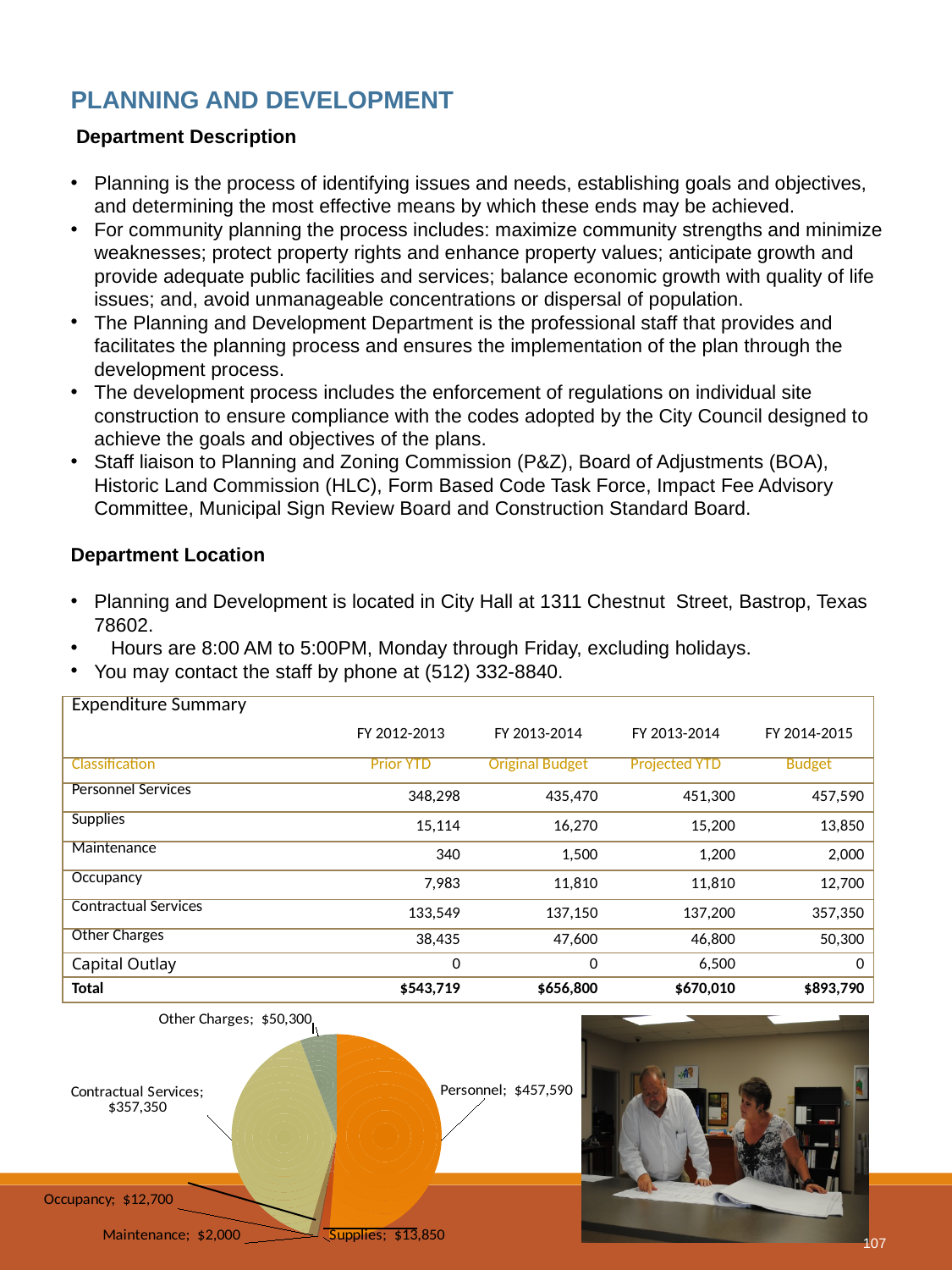
Which slice of the pie chart is the smallest? Maintenance In the pie chart, what is the difference between Personnel and Contractual Services? $100,240 How many slices does the pie chart have? 6 In the pie chart, what is the value for Other Charges? $50,300 What kind of chart is shown at the bottom left of the slide? Pie chart In the pie chart, what is the value for Supplies? $13,850 In the pie chart, what is the value for Maintenance? $2,000 In the pie chart, what is the value for Personnel? $457,590 In the pie chart, what is the value for Occupancy? $12,700 In the pie chart, which is larger, Supplies or Occupancy? Supplies Which slice of the pie chart is the largest? Personnel In the pie chart, what is the value for Contractual Services? $357,350